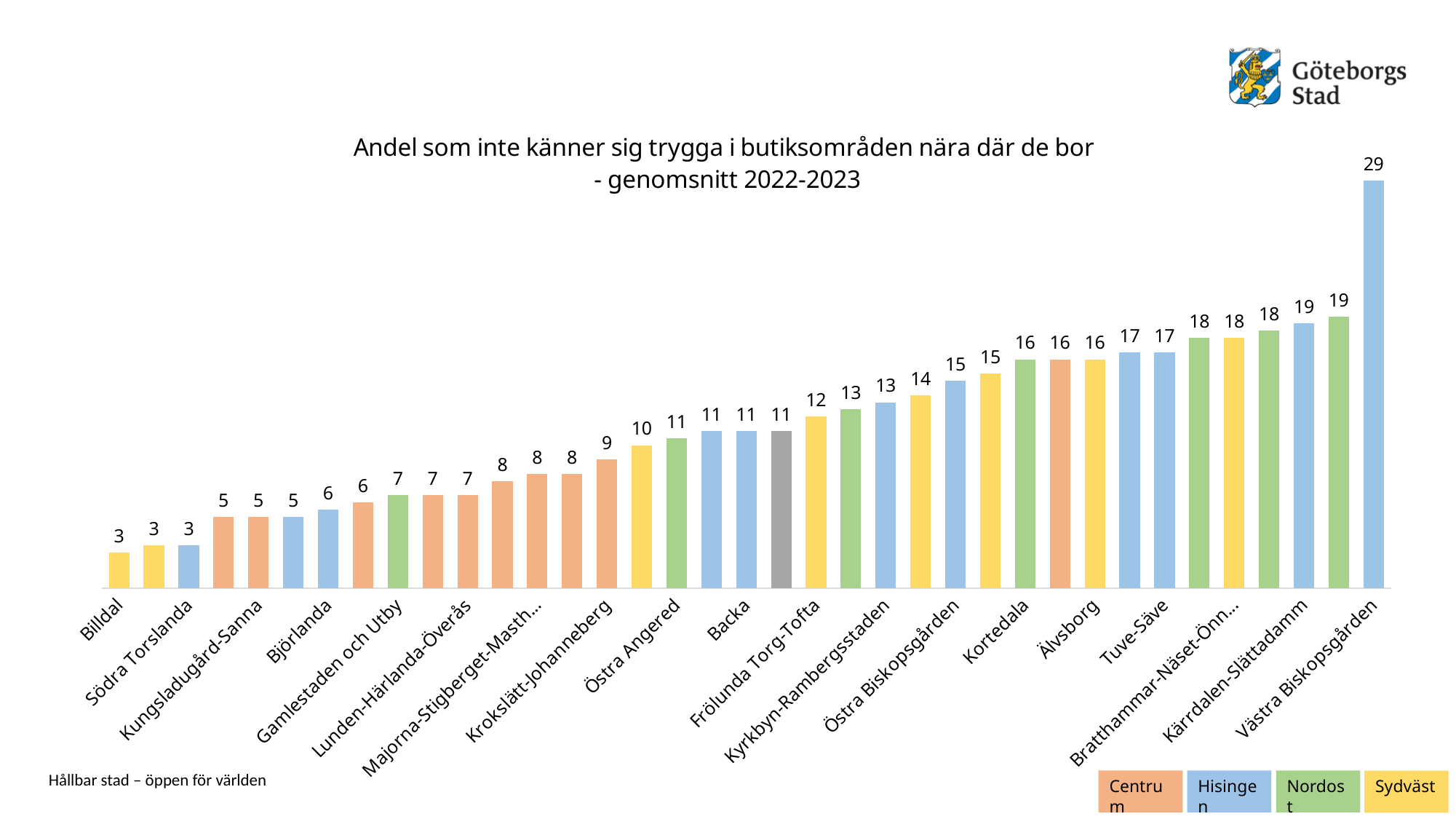
What kind of chart is shown on the slide? bar chart What is the value for Kärrdalen-Slättadamm? 19 What is the value for Västra Biskopsgården? 29 Which is larger, the value for Kortedala or the value for Billdal? Kortedala What is the value for Frölunda Torg-Tofta? 12 What is the value for Kortedala? 16 What is the difference between the values for Västra Biskopsgården and Billdal? 26 What is the value for Billdal? 3 Do the values rise or fall from left to right along the x axis? rise Which area has the highest value? Västra Biskopsgården How many entries does the legend list? 4 How many bars are plotted in the chart? 37